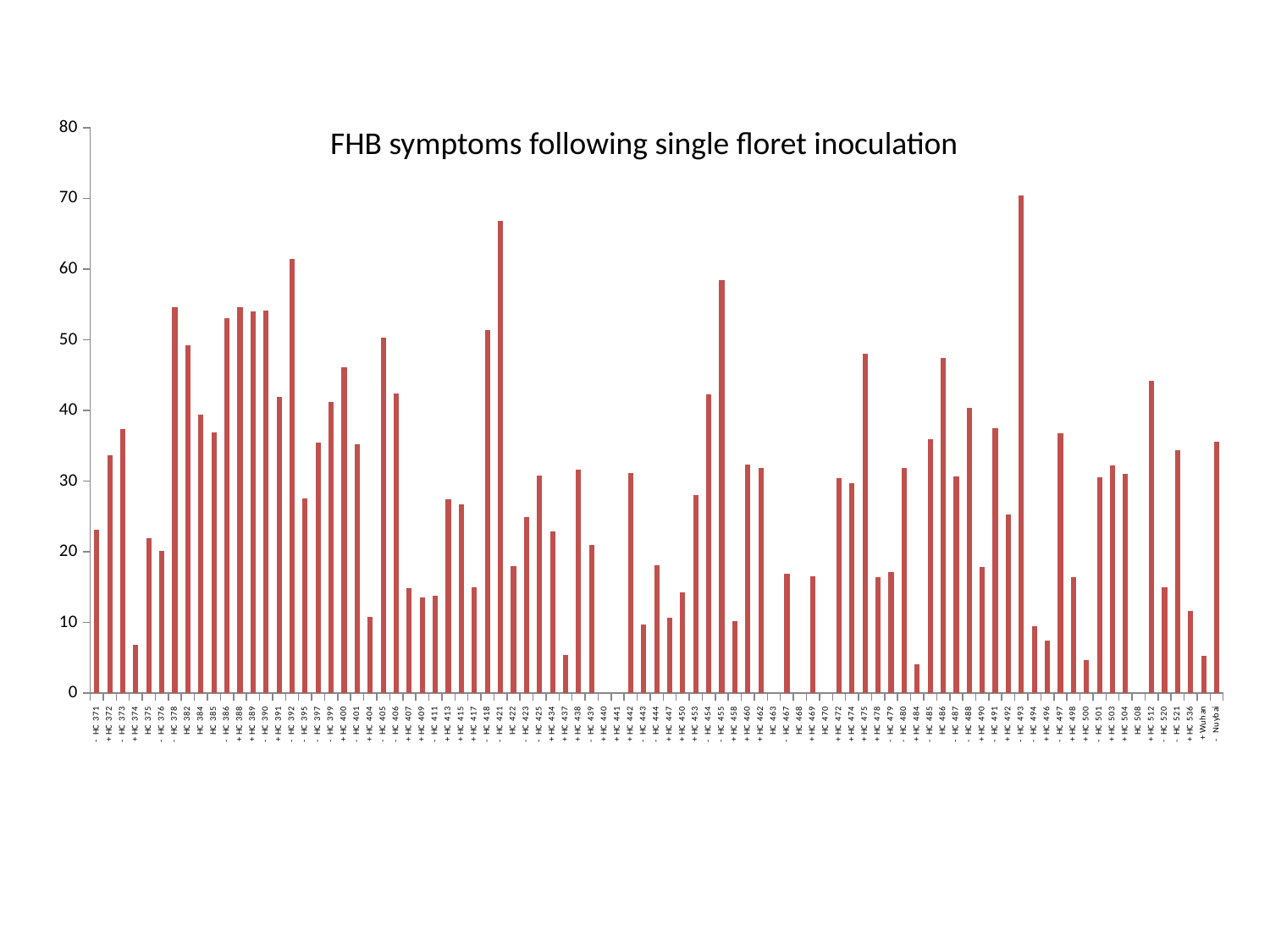
Is the value for HC 374 greater or less than 10? less Is the value for HC 421 greater or less than 60? greater Which has the larger value, HC 493 or HC 421? HC 493 What is the highest value shown on the vertical axis? 80 Is the value for HC 484 greater or less than 10? less Which category has the highest bar in the chart? HC 493 What kind of chart is shown on the slide? bar chart What is the title of the chart? FHB symptoms following single floret inoculation Which has the larger value, HC 378 or HC 382? HC 378